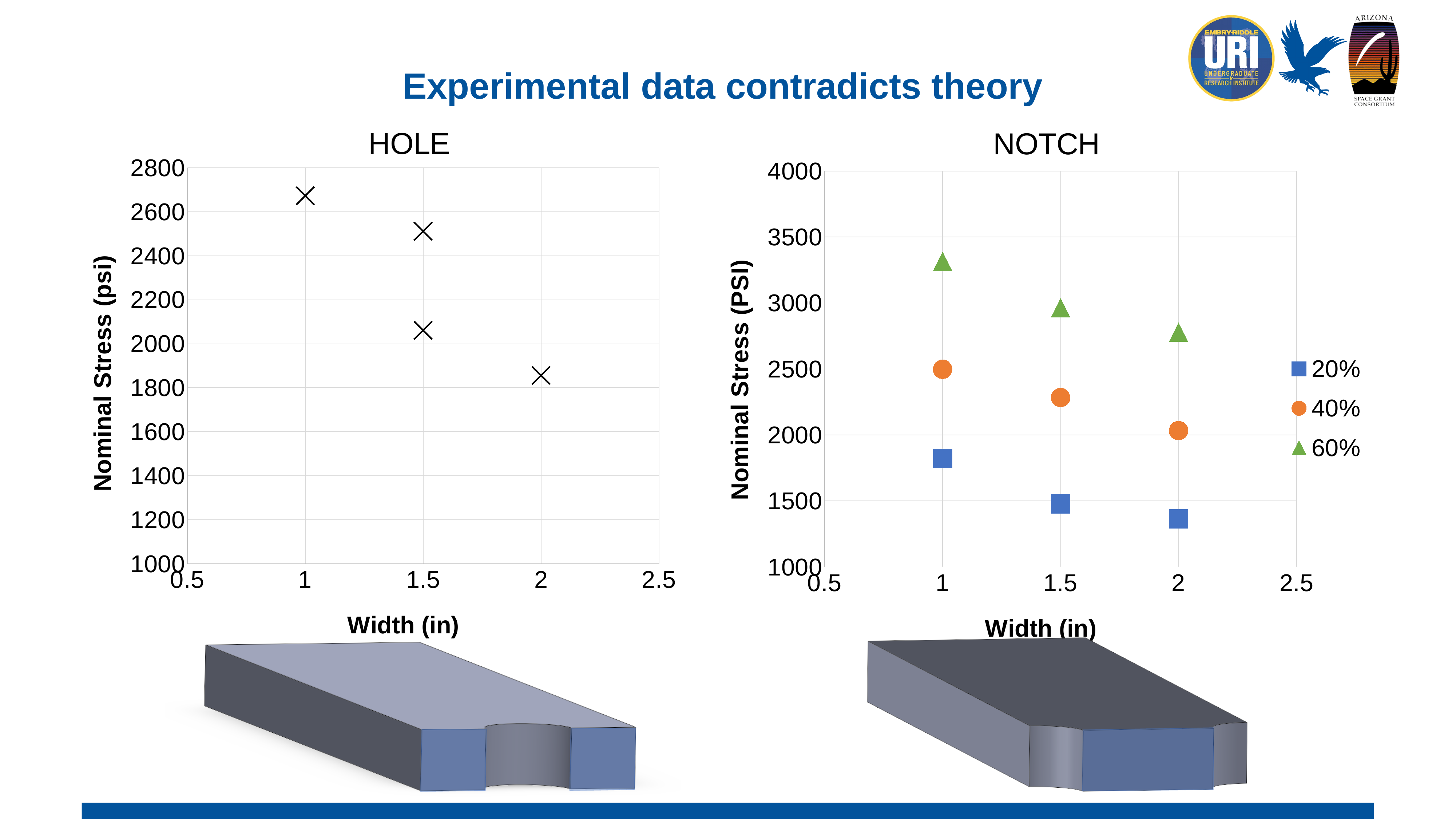
On the NOTCH chart, is the nominal stress for the 60% series at a width of 1 in greater or less than 3000? greater On the HOLE chart, is the nominal stress at a width of 1 in greater or less than 2400? greater On the NOTCH chart, is the nominal stress for the 20% series at a width of 2 in greater or less than 1500? less On the NOTCH chart, at a width of 1 in, which series has the larger nominal stress, 20% or 40%? 40% On the NOTCH chart, which series has the highest nominal stress values? 60% On the NOTCH chart, how many data points does the 60% series have? 3 What kind of chart is the HOLE chart? scatter chart On the NOTCH chart, does the nominal stress for the 60% series rise or fall as width increases? fall How many data points are plotted on the HOLE chart? 4 How many series does the legend of the NOTCH chart list? 3